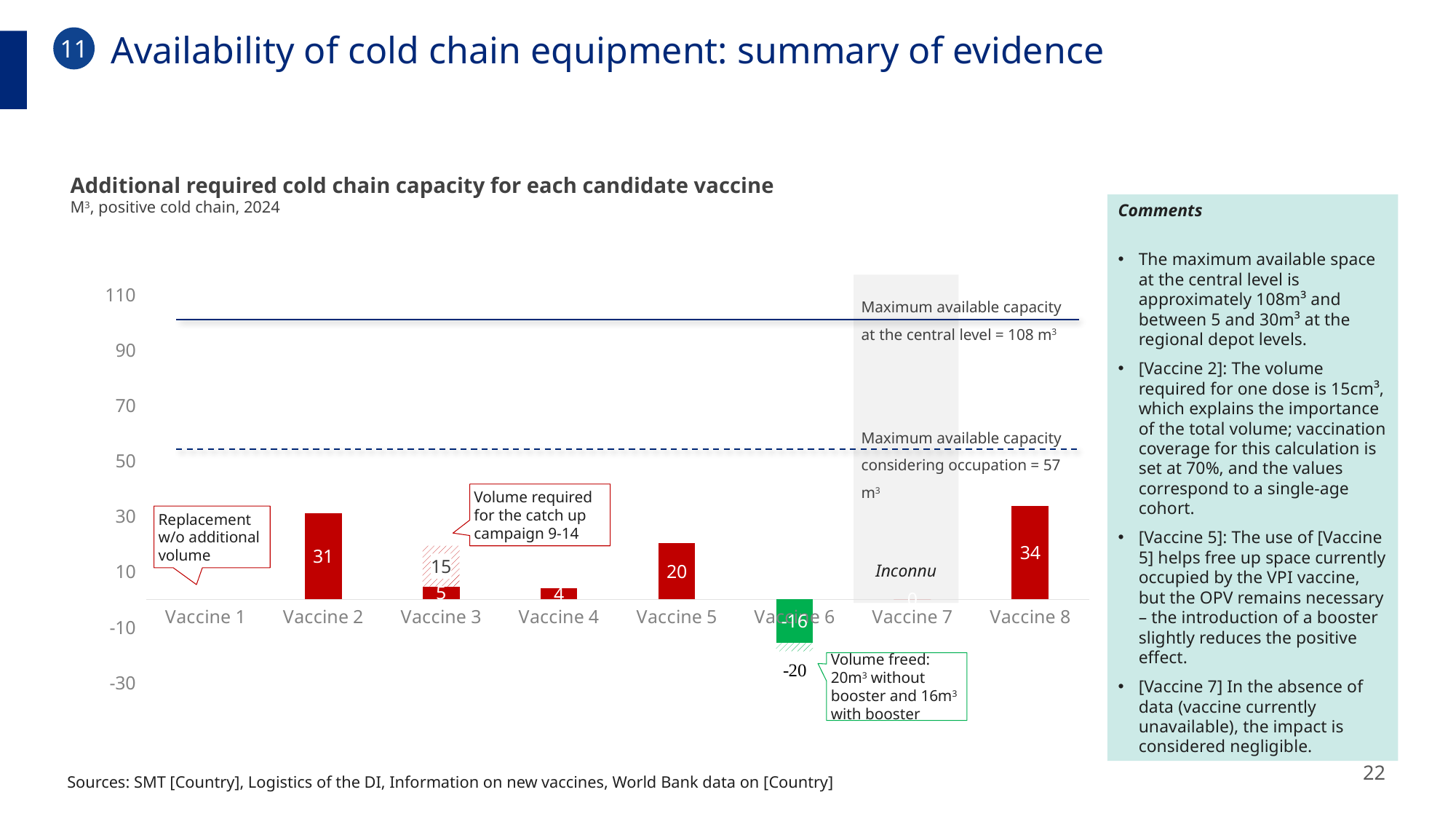
What is the maximum available capacity at the central level shown by the solid line? 108 m³ What is the additional required cold chain capacity for Vaccine 2? 31 What value is shown for Vaccine 6 (the green bar)? -16 Is the value for Vaccine 8 greater or less than 50? less Which vaccine has the highest additional required cold chain capacity? Vaccine 8 Which vaccine has the lowest value on the chart? Vaccine 6 What is the difference between the values for Vaccine 8 and Vaccine 2? 3 How many vaccine categories are shown on the x axis? 8 What is the additional required cold chain capacity for Vaccine 5? 20 What kind of chart is used to show the additional required cold chain capacity? Bar chart Which has a larger additional required capacity, Vaccine 5 or Vaccine 4? Vaccine 5 What is the additional required cold chain capacity for Vaccine 8? 34